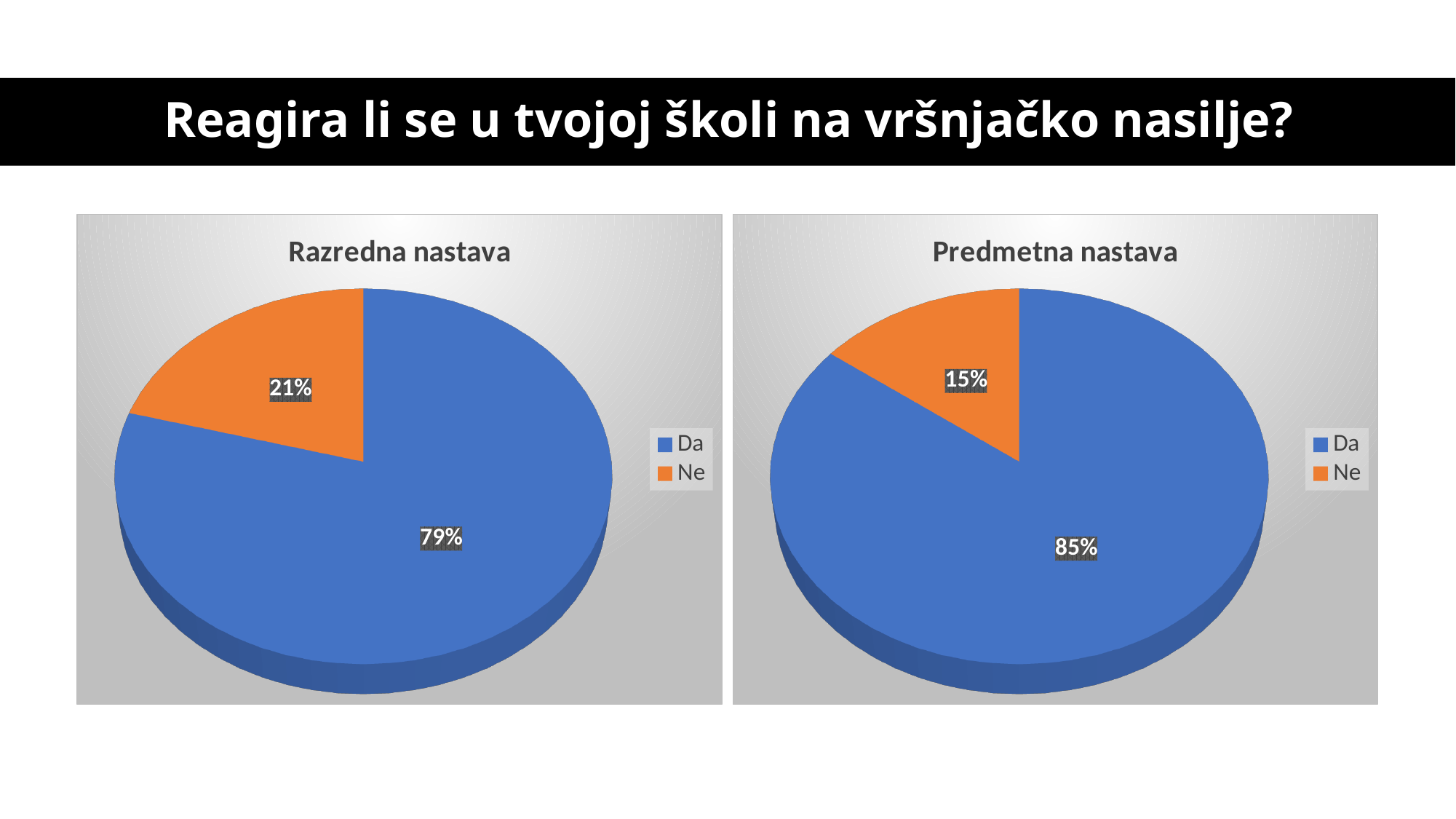
How many slices does the 'Razredna nastava' pie chart have? 2 In the 'Razredna nastava' chart, what percentage is shown for 'Ne'? 21% In the 'Razredna nastava' chart, what colour is the 'Ne' slice? Orange Which chart has the larger 'Da' share, 'Razredna nastava' or 'Predmetna nastava'? Predmetna nastava How many entries does the legend of the 'Predmetna nastava' chart list? 2 What type of chart is the 'Predmetna nastava' chart? Pie chart In the 'Predmetna nastava' chart, which slice is the smallest? Ne In the 'Predmetna nastava' chart, what percentage is shown for 'Da'? 85% In the 'Razredna nastava' chart, which slice is the largest? Da In the 'Predmetna nastava' chart, what percentage is shown for 'Ne'? 15% In the 'Razredna nastava' chart, what is the difference between the 'Da' and 'Ne' percentages? 58% In the 'Razredna nastava' chart, what percentage is shown for 'Da'? 79%